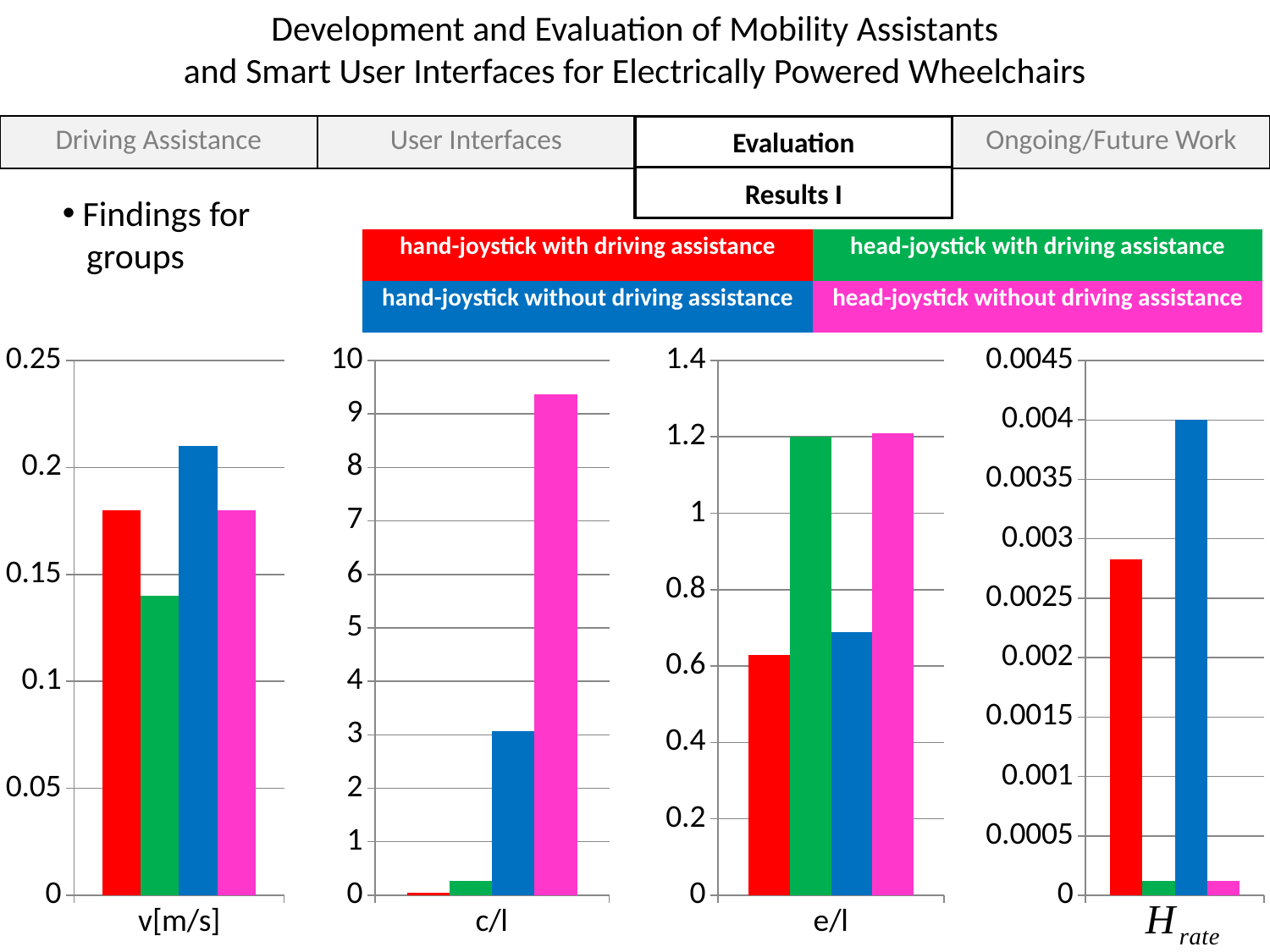
What colour represents hand-joystick with driving assistance in the legend? red In the e/l chart, is the value for head-joystick with driving assistance greater or less than 1? greater In the e/l chart, is the value for hand-joystick with driving assistance greater or less than 0.8? less In the c/l chart, which series has the highest value? head-joystick without driving assistance In the v[m/s] chart, which series has the highest value? hand-joystick without driving assistance In the c/l chart, is the value for head-joystick without driving assistance greater or less than 9? greater In the v[m/s] chart, which series has the lowest value? head-joystick with driving assistance In the H_rate chart, which series has the highest value? hand-joystick without driving assistance What kind of chart is the v[m/s] chart? bar chart How many series does the legend list for the charts? 4 In the c/l chart, which is larger: hand-joystick without driving assistance or head-joystick without driving assistance? head-joystick without driving assistance